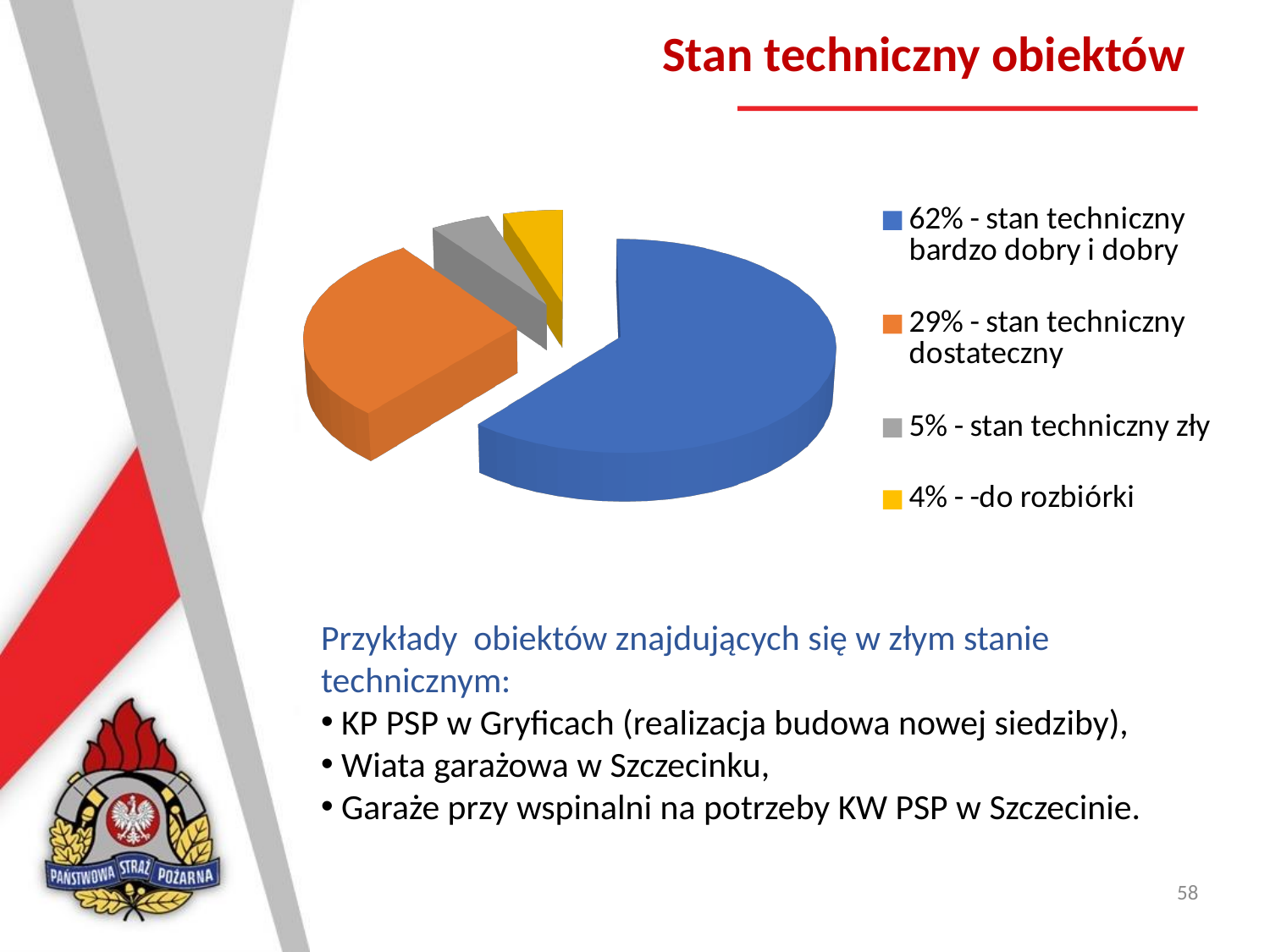
What is the title of the slide containing the pie chart? Stan techniczny obiektów What share of the pie is 'stan techniczny dostateczny'? 29% What share of the pie is 'stan techniczny bardzo dobry i dobry'? 62% How many slices does the pie chart have? 4 What share of the pie is 'do rozbiórki'? 4% What colour is the slice for 'stan techniczny dostateczny'? orange Which is larger: the share for 'stan techniczny zły' or the share for 'do rozbiórki'? stan techniczny zły What kind of chart is shown on the slide? pie chart What is the difference in percentage points between 'stan techniczny bardzo dobry i dobry' and 'stan techniczny dostateczny'? 33 Which category has the smallest slice of the pie? do rozbiórki Which category has the largest slice of the pie? stan techniczny bardzo dobry i dobry